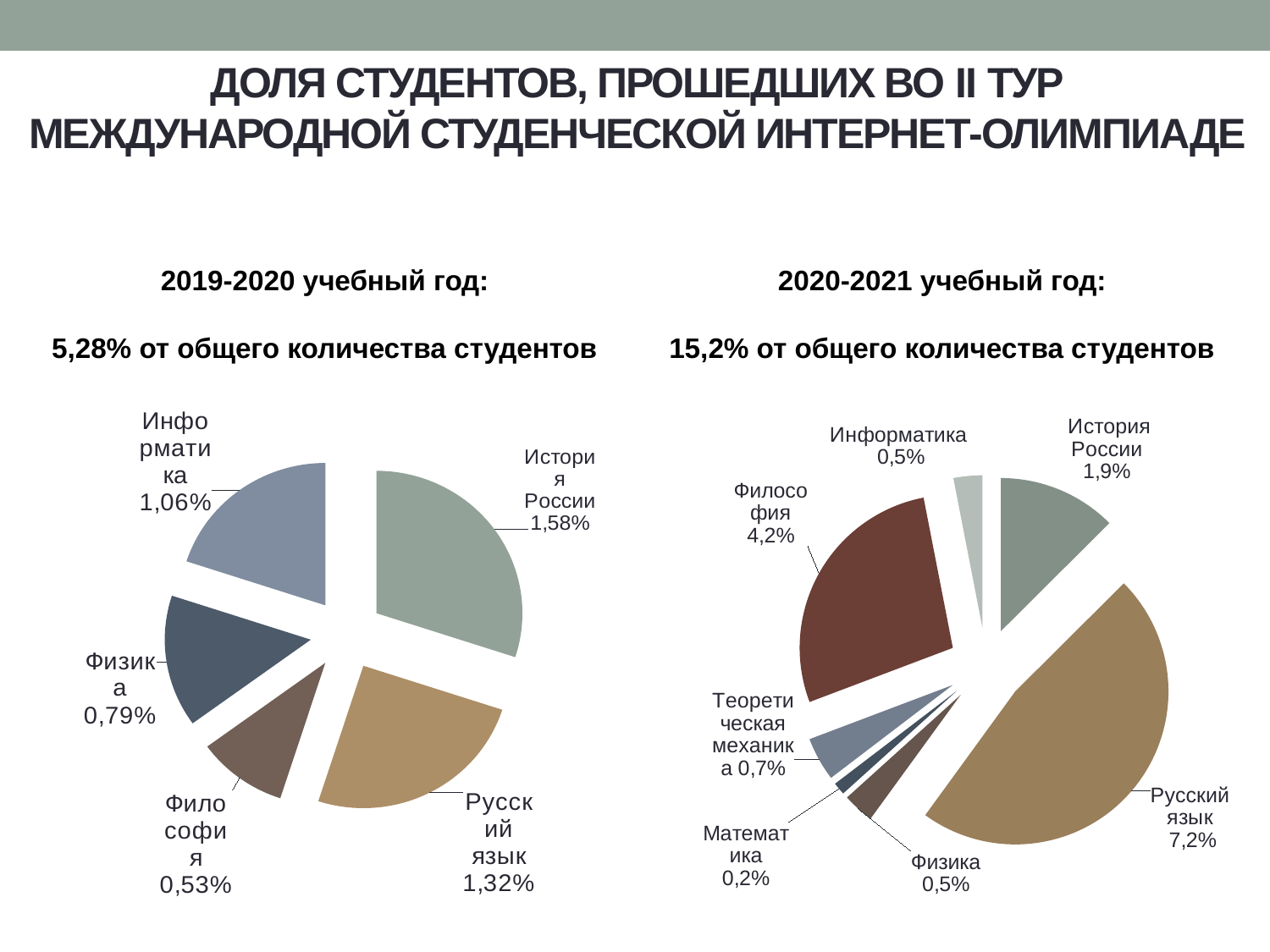
In the 2020-2021 chart, which category has the highest value? Русский язык In the 2019-2020 chart, what is the value for История России? 1,58% In the 2019-2020 chart, which is larger, Русский язык or Информатика? Русский язык How many categories are shown in the 2020-2021 chart? 7 In the 2020-2021 chart, which category has the lowest value? Математика In the 2019-2020 chart, which category has the highest value? История России In the 2020-2021 chart, what is the value for Русский язык? 7,2% What kind of chart is used for the 2019-2020 data? Pie chart In the 2019-2020 chart, what is the difference between Информатика and Физика? 0,27% In the 2019-2020 chart, what is the value for Философия? 0,53% In the 2020-2021 chart, what is the difference between Русский язык and Философия? 3,0% In the 2020-2021 chart, what is the value for Теоретическая механика? 0,7%